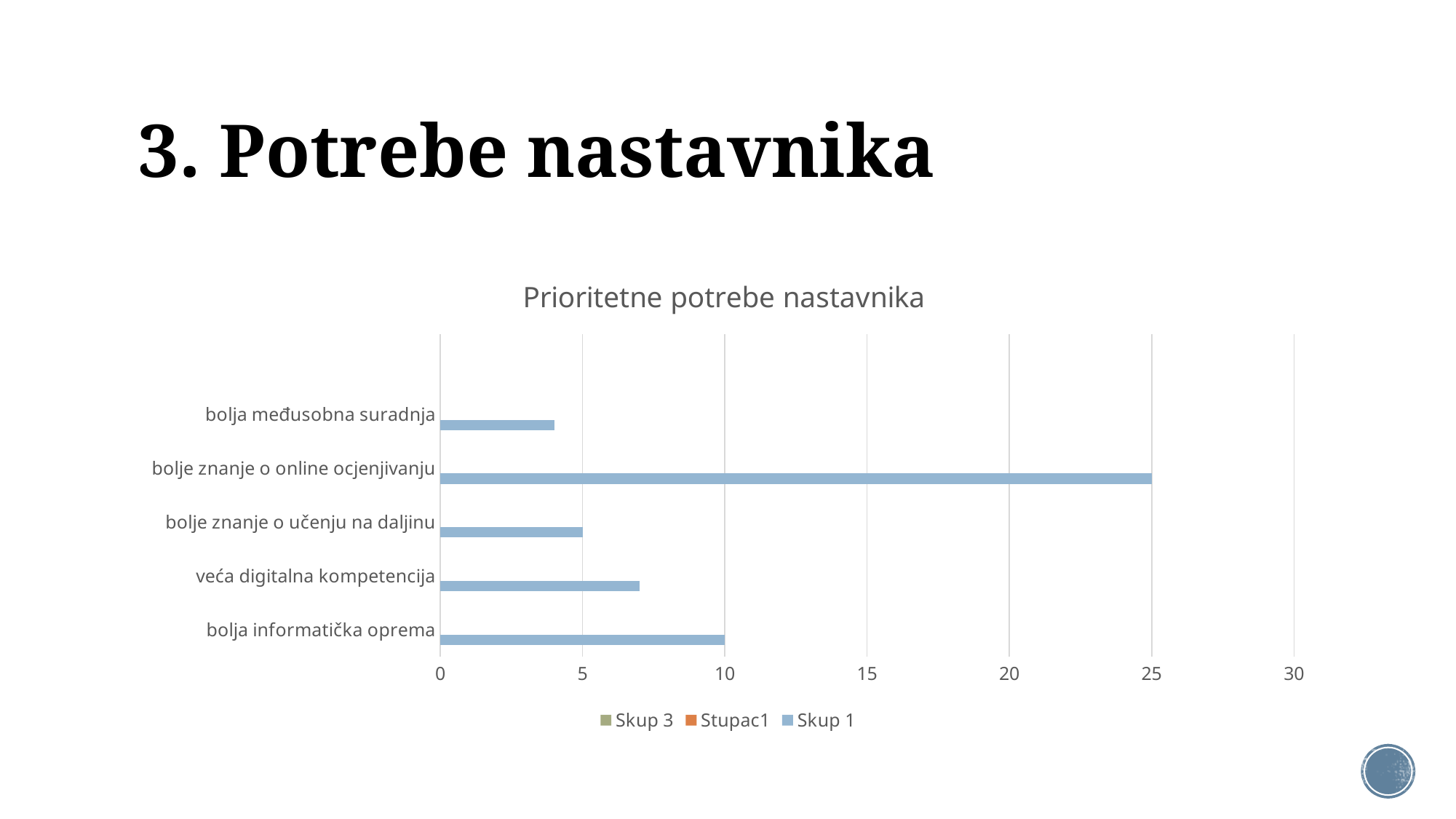
What is the difference between the values for bolje znanje o online ocjenjivanju and bolja informatička oprema? 15 Which category has the lowest value? bolja međusobna suradnja What is the title of the chart? Prioritetne potrebe nastavnika How many series does the legend list? 3 Is the value for veća digitalna kompetencija greater or less than 5? greater What kind of chart is shown on the slide? bar chart What is the value for bolje znanje o učenju na daljinu? 5 What is the value for bolje znanje o online ocjenjivanju? 25 Which is larger, the value for bolja informatička oprema or the value for veća digitalna kompetencija? bolja informatička oprema Which category has the highest value? bolje znanje o online ocjenjivanju How many categories are plotted in the chart? 5 What is the value for bolja informatička oprema? 10